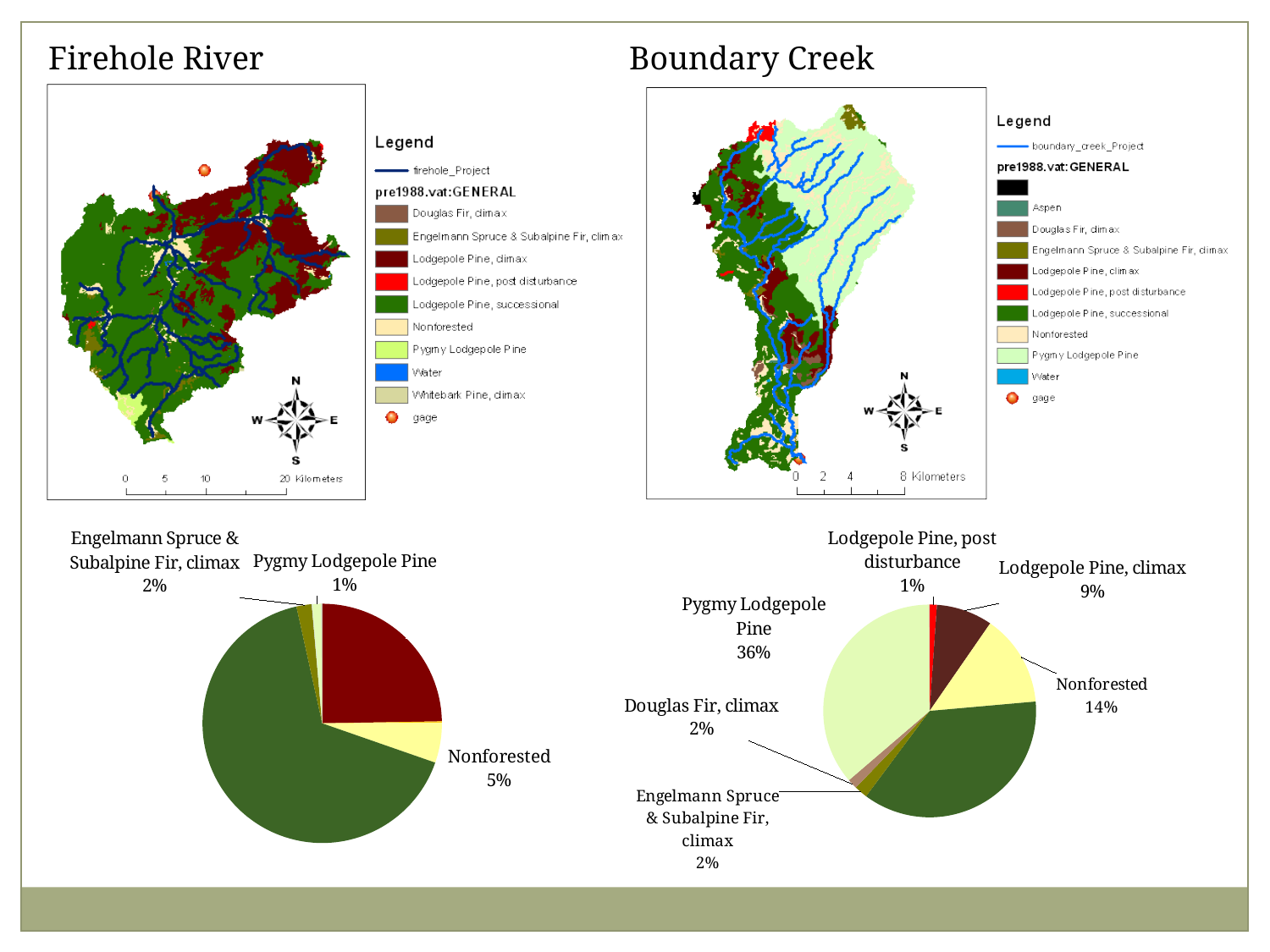
In the Firehole River pie chart, which labeled slice has the smallest share? Pygmy Lodgepole Pine Which is larger: the Nonforested share in the Boundary Creek pie chart or the Nonforested share in the Firehole River pie chart? Boundary Creek In the Boundary Creek pie chart, which labeled slice has the smallest share? Lodgepole Pine, post disturbance In the Firehole River pie chart, what share is labeled for Pygmy Lodgepole Pine? 1% In the Firehole River pie chart, what share is labeled for Nonforested? 5% In the Boundary Creek pie chart, how many percentage points larger is Nonforested than Lodgepole Pine, climax? 5 In the Boundary Creek pie chart, what share is labeled for Pygmy Lodgepole Pine? 36% In the Boundary Creek pie chart, what share is labeled for Nonforested? 14% How many slices does the Boundary Creek pie chart have? 7 In the Boundary Creek pie chart, what share is labeled for Lodgepole Pine, climax? 9% In the Firehole River pie chart, what share is labeled for Engelmann Spruce & Subalpine Fir, climax? 2% What kind of chart is shown below the Firehole River map? pie chart